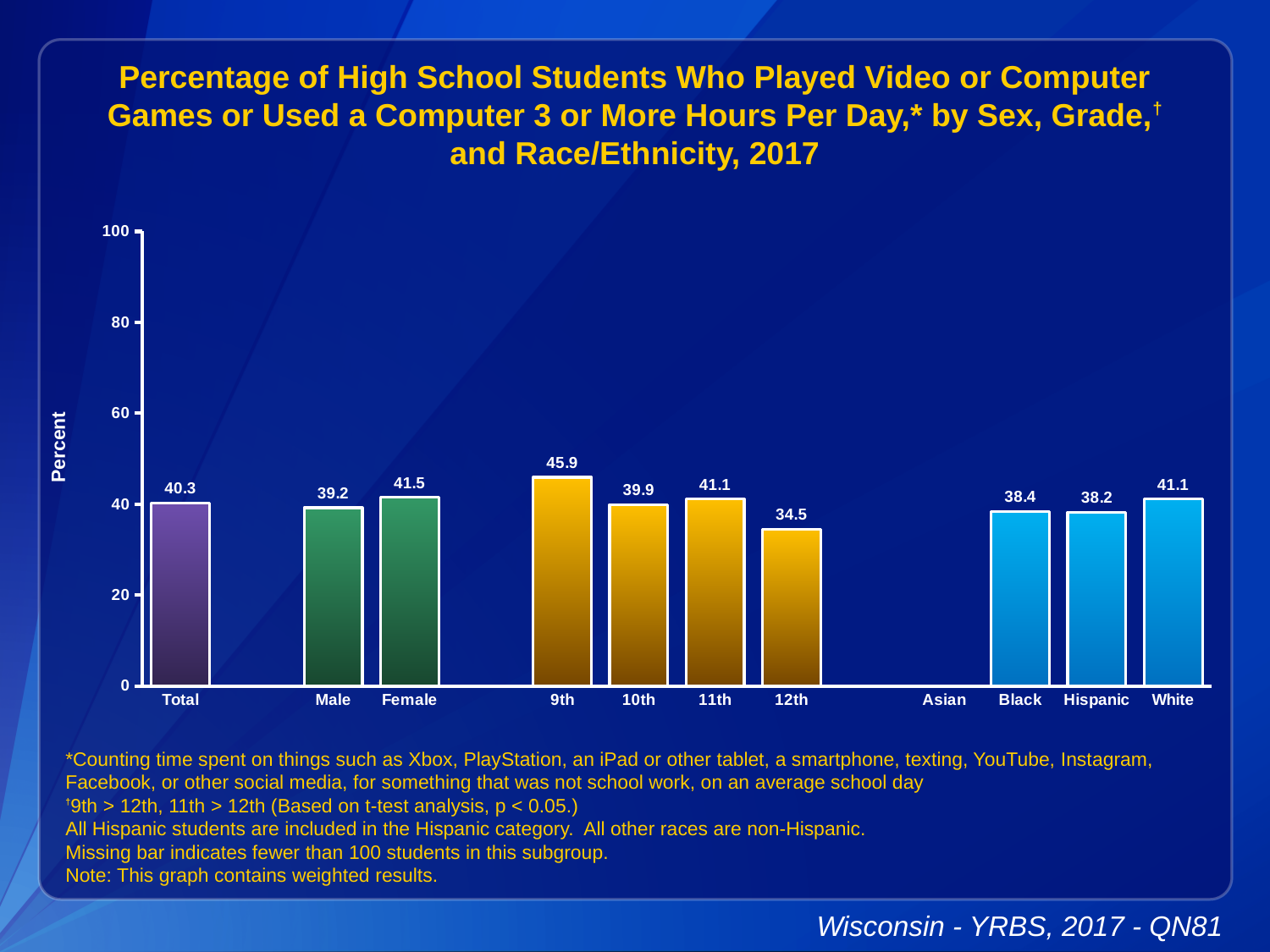
What is the value for Total? 40.3 What is the value for Female? 41.5 Is the value for 9th grade greater or less than 40? greater Which is larger, the value for Male or the value for Female? Female What is the value for 12th grade? 34.5 Which category has the highest value? 9th What is the difference between the values for 9th and 12th grade? 11.4 What is the difference between the values for Female and Male? 2.3 What is the value for Hispanic? 38.2 What kind of chart is shown on the slide? Bar chart Which category has the lowest value among those with a bar? 12th Which category on the x axis has no bar shown? Asian